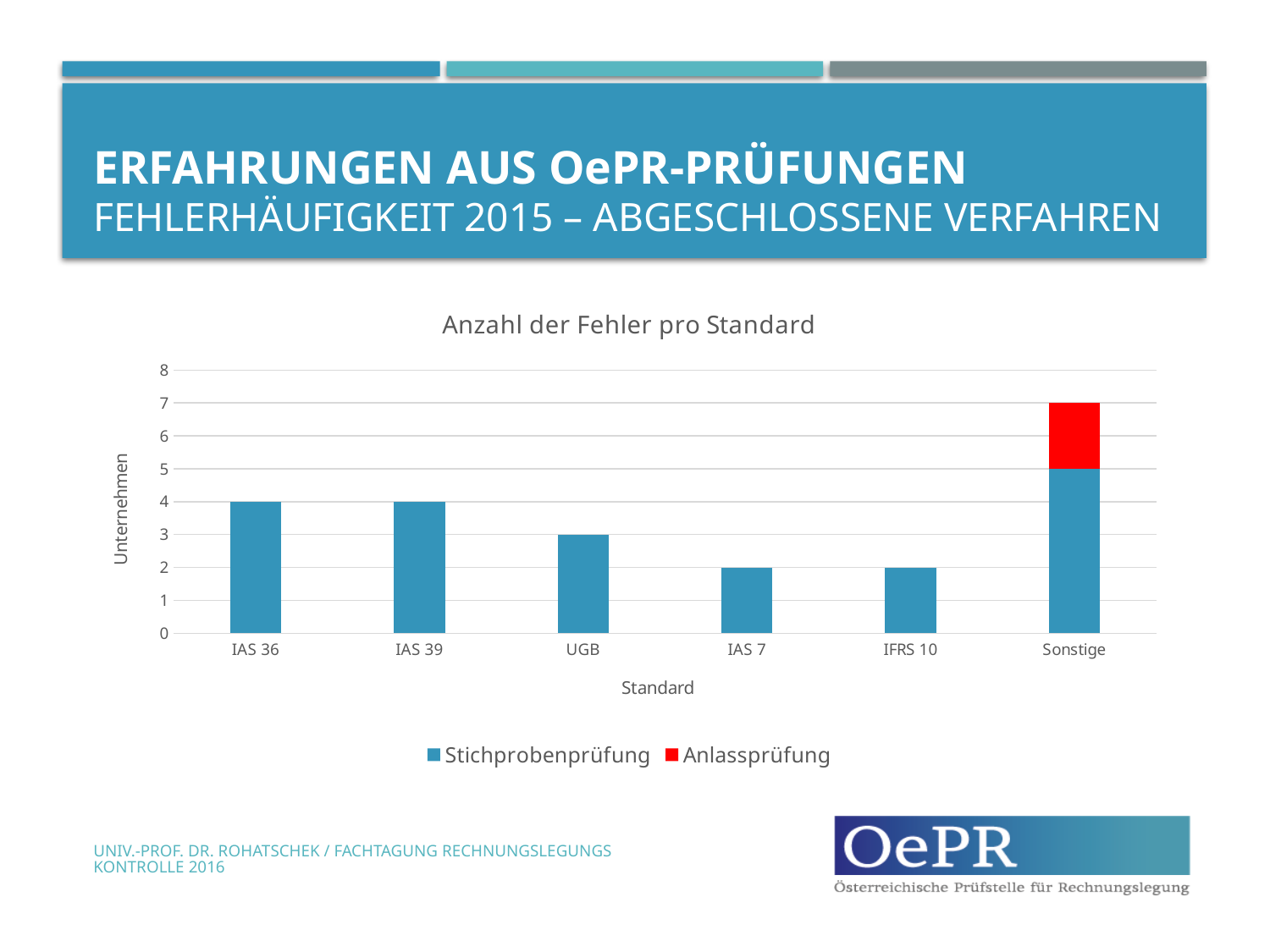
Which is larger, the Stichprobenprüfung value for UGB or for IFRS 10? UGB Which category is the only one with an Anlassprüfung segment? Sonstige Which category has the highest total number of Unternehmen? Sonstige What is the title of the chart? Anzahl der Fehler pro Standard What kind of chart is shown on the slide? Bar chart What is the total height of the stacked bar for Sonstige? 7 What is the difference between the Stichprobenprüfung values for IAS 39 and IAS 7? 2 What is the Stichprobenprüfung value for IFRS 10? 2 What is the Stichprobenprüfung value for IAS 36? 4 What is the Stichprobenprüfung value for UGB? 3 How many categories are shown on the x axis? 6 How many series does the legend list? 2